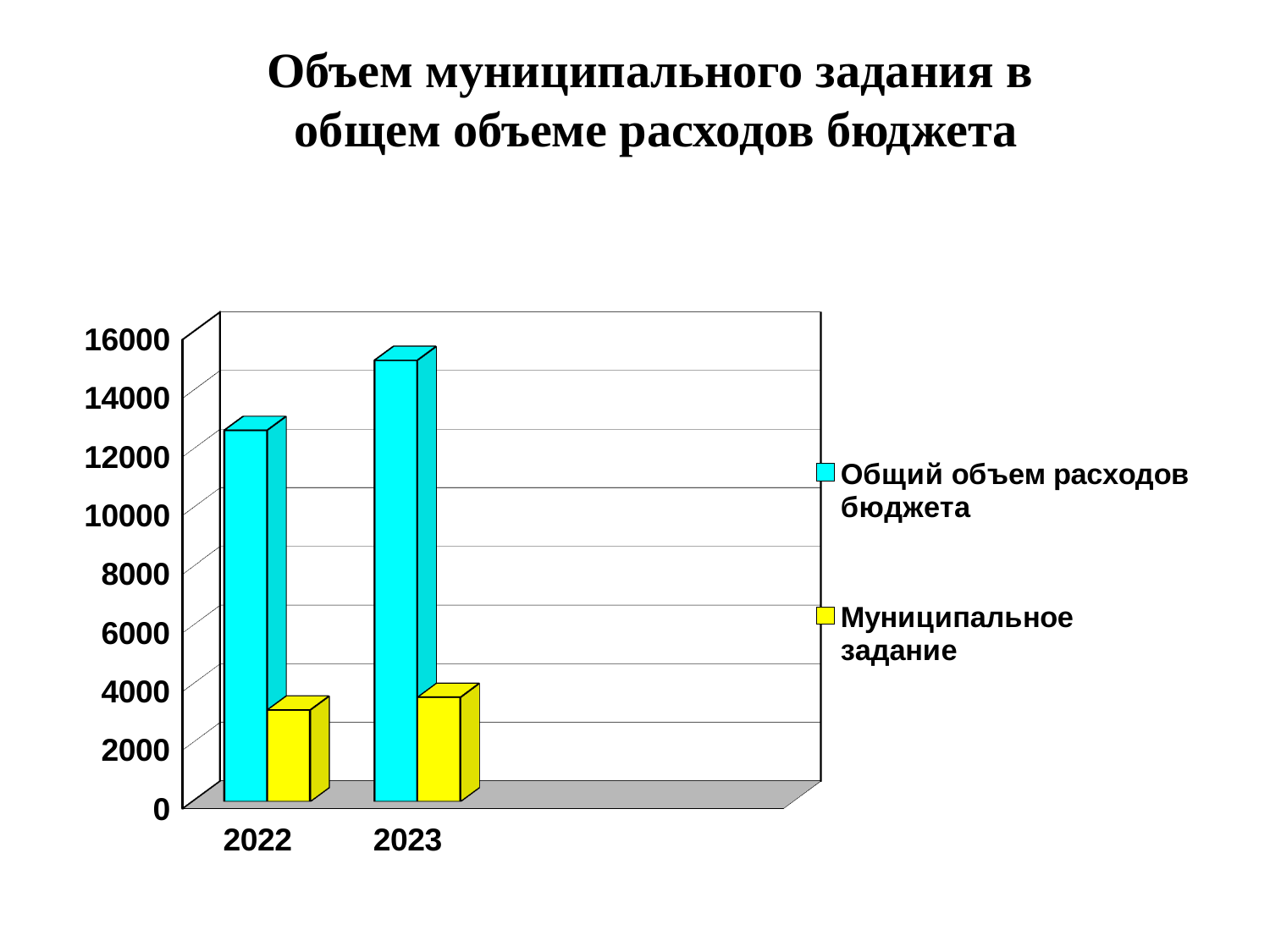
Is the value for Общий объем расходов бюджета in 2022 greater or less than 12000? greater Is the value for Муниципальное задание in 2022 greater or less than 4000? less Is the value for Общий объем расходов бюджета in 2023 greater or less than 14000? greater Which year has the higher value for Муниципальное задание, 2022 or 2023? 2023 Which year has the higher value for Общий объем расходов бюджета, 2022 or 2023? 2023 What kind of chart is shown on the slide? bar chart How many series does the legend list? 2 How many categories are shown on the x axis? 2 Which series is shown in yellow? Муниципальное задание What is the title of the chart? Объем муниципального задания в общем объеме расходов бюджета Does the value for Общий объем расходов бюджета rise or fall from 2022 to 2023? rise